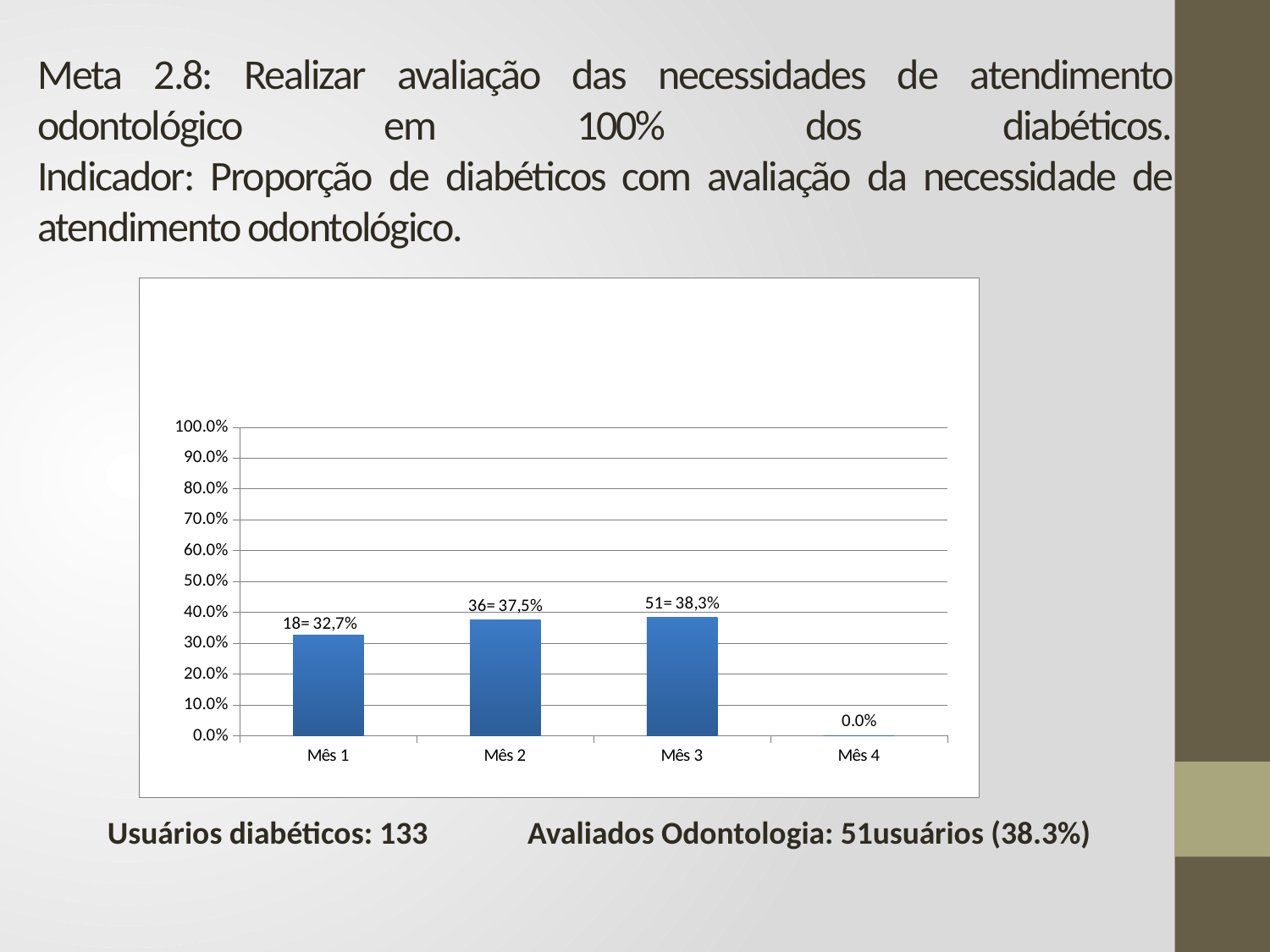
What is the data label shown for Mês 2? 36= 37,5% Is the value for Mês 3 greater or less than 50.0%? less Which is larger, the value for Mês 1 or the value for Mês 2? Mês 2 Which month has the highest value in the chart? Mês 3 What is the data label shown for Mês 1? 18= 32,7% Which month has the lowest value in the chart? Mês 4 What is the highest value shown on the y axis of the chart? 100.0% How many categories (months) are shown on the x axis of the chart? 4 What value is shown for Mês 4? 0.0% What kind of chart is shown on the slide? bar chart Do the values rise or fall from Mês 1 to Mês 3? rise What is the data label shown for Mês 3? 51= 38,3%